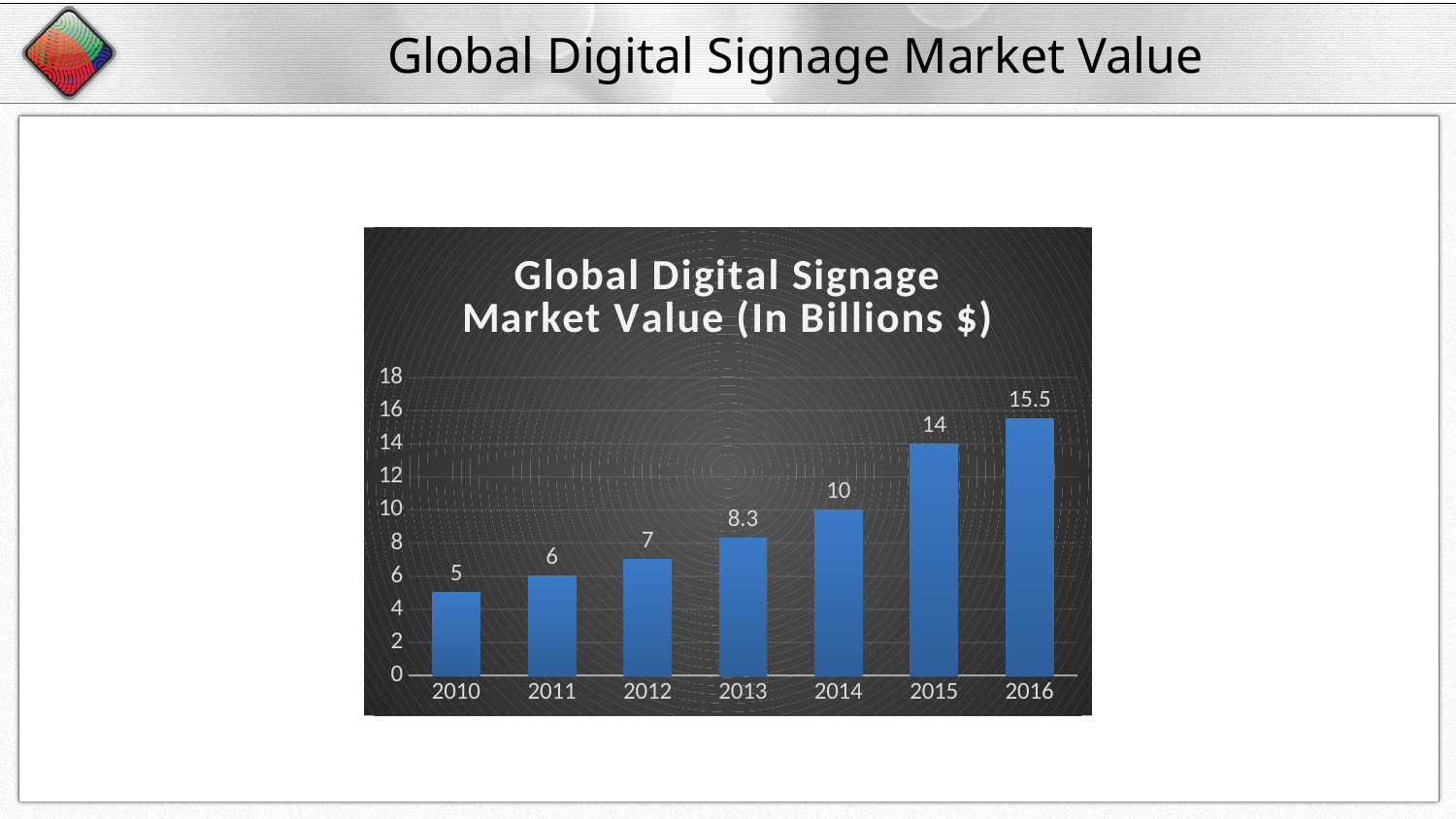
What kind of chart is shown? bar chart Is the value for 2015 greater or less than 12? greater What is the value for 2013? 8.3 What is the difference between the values for 2016 and 2010? 10.5 What is the difference between the values for 2015 and 2014? 4 What is the value for 2016? 15.5 Which year has the highest value? 2016 Do the values rise or fall from 2010 to 2016? rise Which year has the lowest value? 2010 How many years are shown on the x axis? 7 What is the value for 2010? 5 Which is larger, the value for 2012 or the value for 2014? 2014